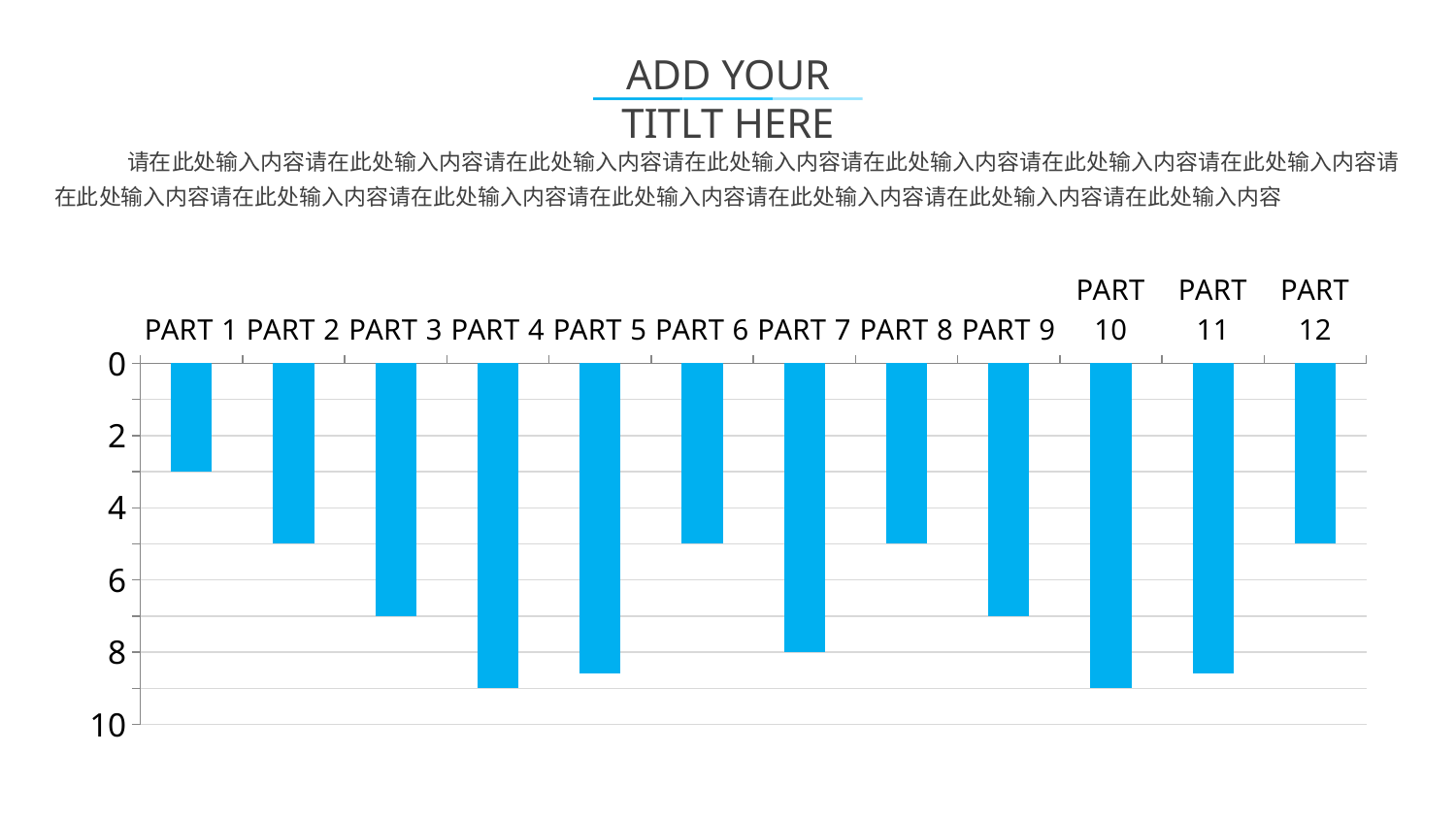
Is the value for PART 1 greater or less than 4? less Is the value for PART 6 greater or less than 6? less How many categories (PART bars) does the chart show? 12 What colour are the bars in the chart? blue What is the value for PART 7? 8 Which is larger, the value for PART 5 or the value for PART 8? PART 5 What kind of chart is shown on the slide? bar chart Is the value for PART 12 greater or less than 4? greater Which category has the smallest bar? PART 1 Which is larger, the value for PART 3 or the value for PART 2? PART 3